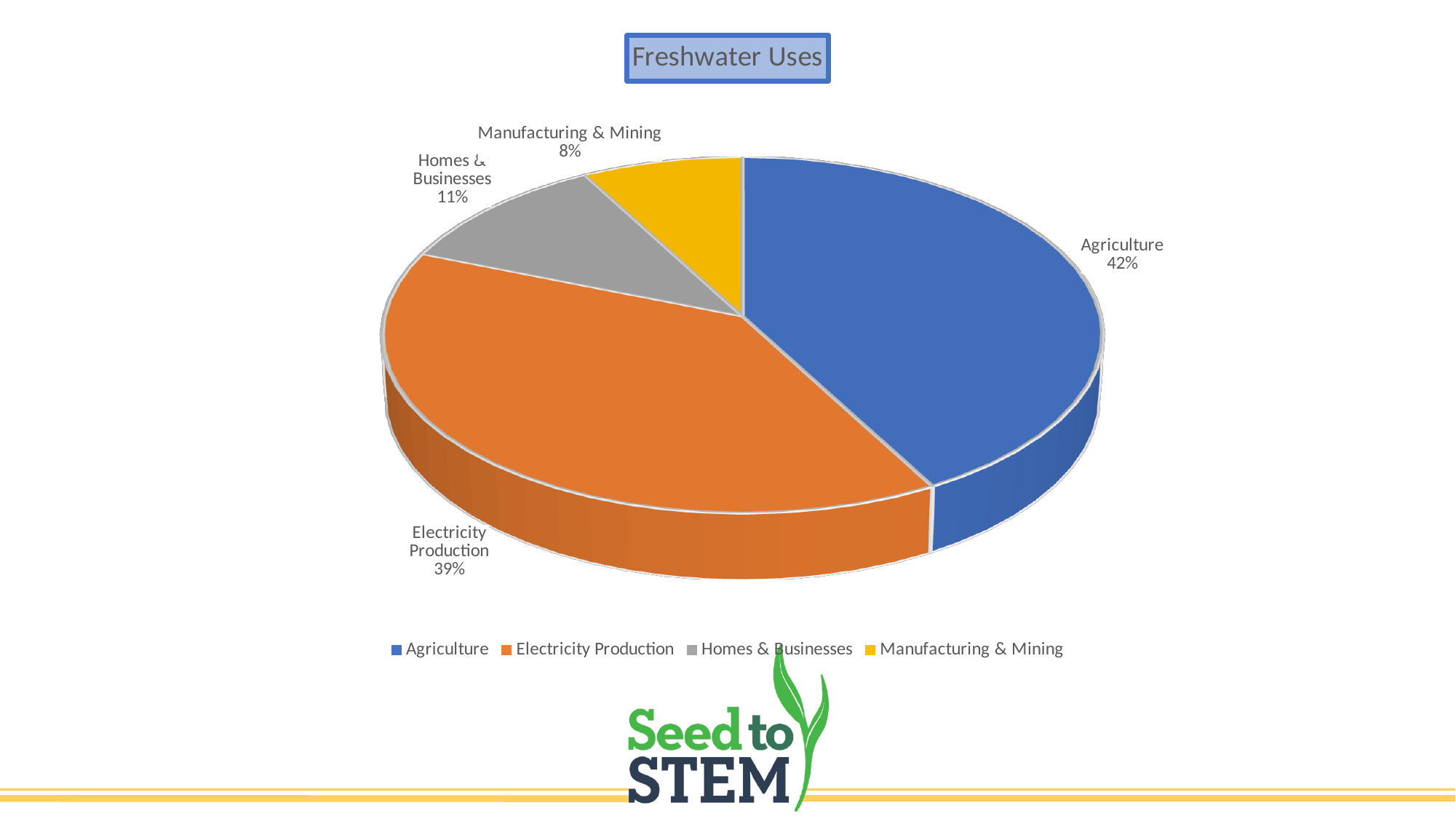
How many categories are shown in the pie chart? 4 What percentage of freshwater use is Homes & Businesses? 11% Which category has the smallest share of freshwater use? Manufacturing & Mining What colour is the Electricity Production slice? Orange What kind of chart is shown on the slide? Pie chart What is the title of the chart? Freshwater Uses What percentage of freshwater use is Electricity Production? 39% Which category has the largest share of freshwater use? Agriculture What percentage of freshwater use is Manufacturing & Mining? 8% What is the difference in percentage points between Agriculture and Electricity Production? 3 What percentage of freshwater use is Agriculture? 42% Which is larger, the share for Homes & Businesses or the share for Manufacturing & Mining? Homes & Businesses